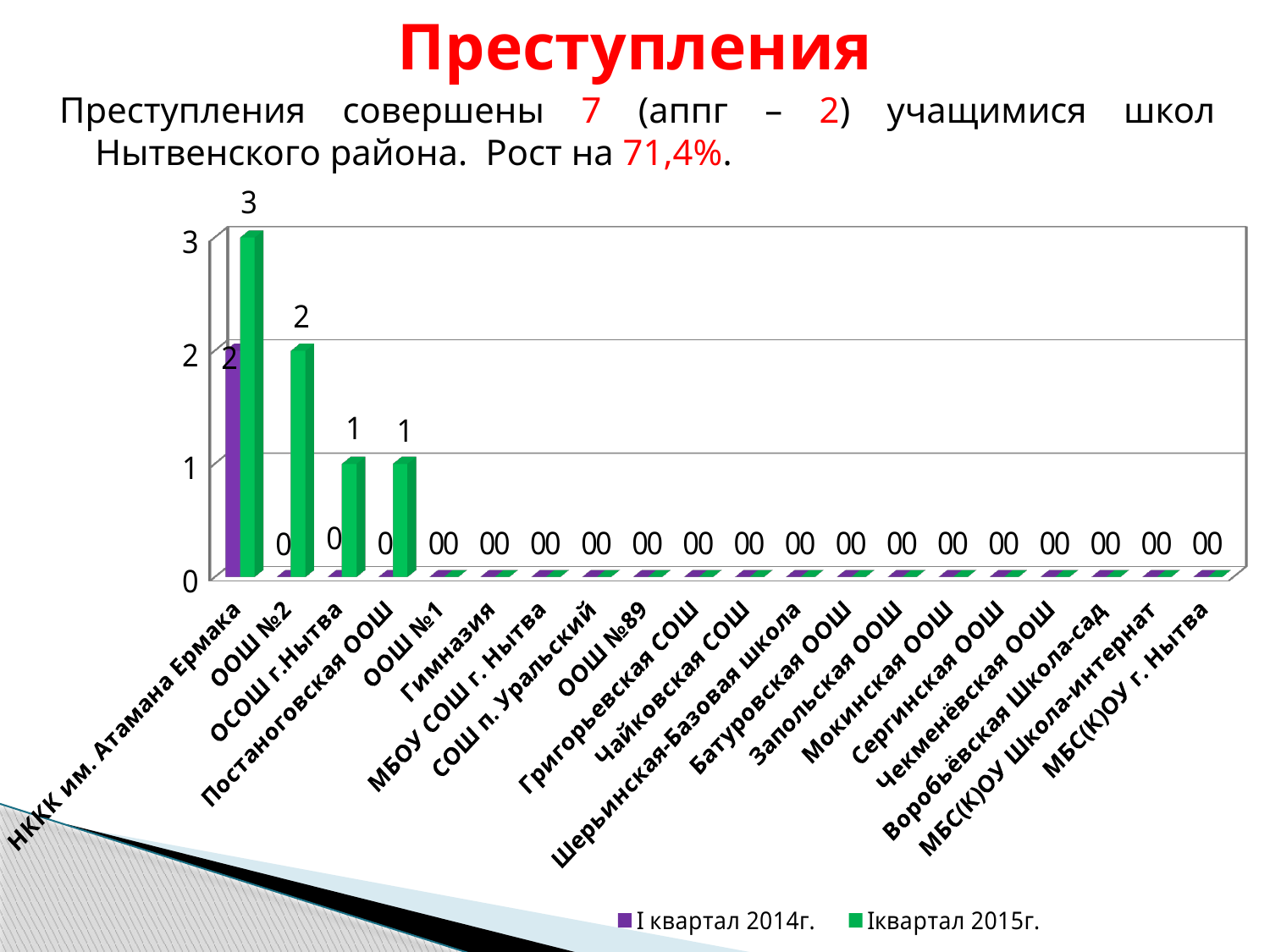
Which category has the highest value in the I квартал 2015г. series? НККК им. Атамана Ермака What is the value for НККК им. Атамана Ермака in the I квартал 2014г. series? 2 What kind of chart is shown on the slide? bar chart What is the value for ООШ №2 in the I квартал 2015г. series? 2 What is the value for НККК им. Атамана Ермака in the I квартал 2015г. series? 3 What colour represents the I квартал 2015г. series? green What is the value for ОСОШ г.Нытва in the I квартал 2015г. series? 1 How many series does the legend list? 2 Which is larger for ООШ №2: the I квартал 2014г. value or the I квартал 2015г. value? I квартал 2015г. How many categories are shown on the x axis? 20 What is the value for Гимназия in the I квартал 2015г. series? 0 What is the difference between the I квартал 2015г. and I квартал 2014г. values for НККК им. Атамана Ермака? 1